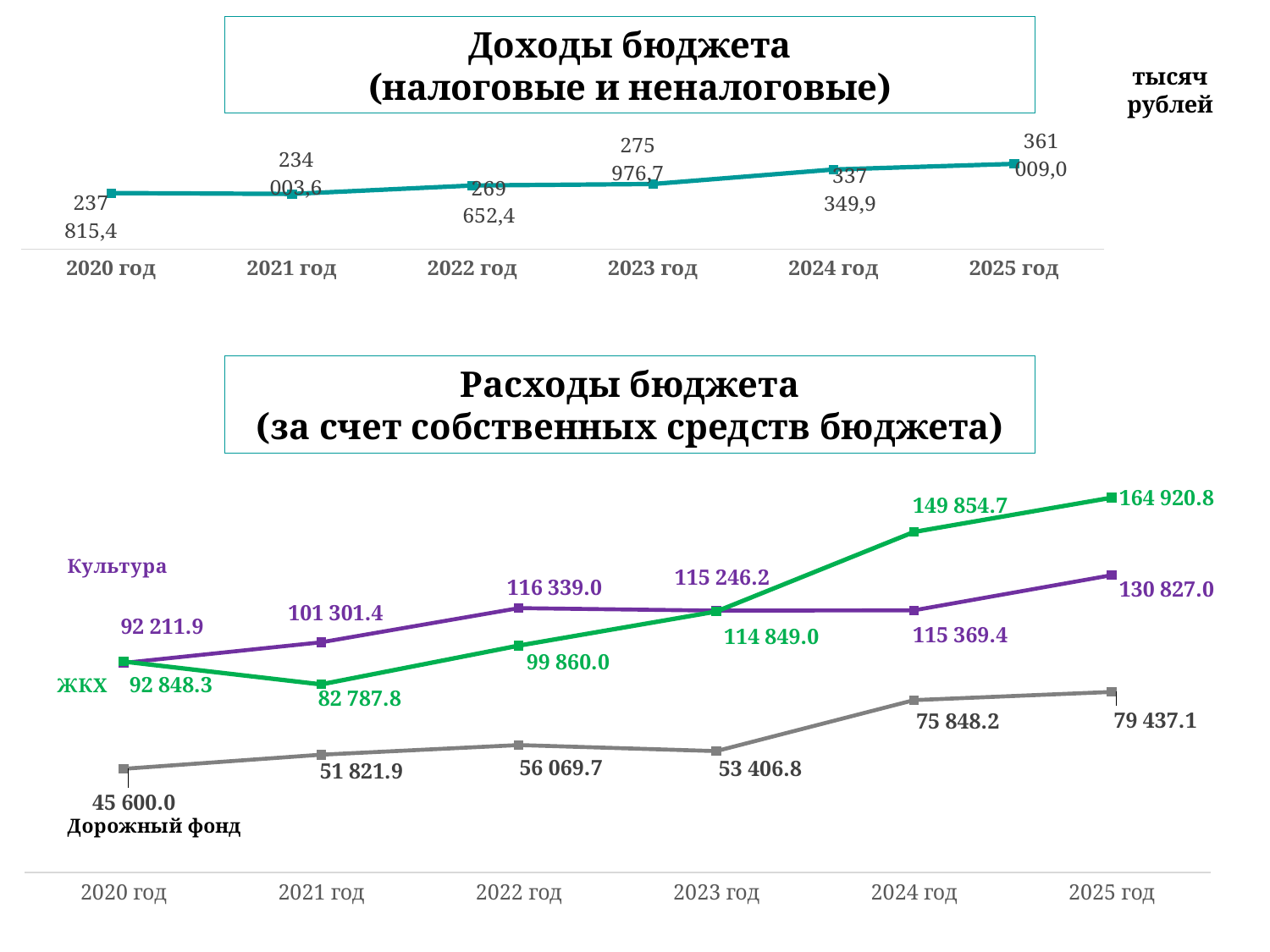
What type of chart is used for "Расходы бюджета (за счет собственных средств бюджета)"? Line chart On the chart titled "Доходы бюджета (налоговые и неналоговые)", which year has the lowest value? 2021 год On the chart titled "Доходы бюджета (налоговые и неналоговые)", which year has the highest value? 2025 год On the chart titled "Расходы бюджета (за счет собственных средств бюджета)", which series has the highest value in 2025 год? ЖКХ On the chart titled "Доходы бюджета (налоговые и неналоговые)", how many years are plotted? 6 On the chart titled "Расходы бюджета (за счет собственных средств бюджета)", which is larger in 2021 год: Культура or ЖКХ? Культура On the chart titled "Расходы бюджета (за счет собственных средств бюджета)", what is the value for Культура in 2022 год? 116 339.0 On the chart titled "Доходы бюджета (налоговые и неналоговые)", what is the value for 2021 год? 234 003,6 On the chart titled "Расходы бюджета (за счет собственных средств бюджета)", what is the value for ЖКХ in 2024 год? 149 854.7 On the chart titled "Расходы бюджета (за счет собственных средств бюджета)", what is the value for Дорожный фонд in 2020 год? 45 600.0 On the chart titled "Доходы бюджета (налоговые и неналоговые)", what is the value for 2025 год? 361 009,0 On the chart titled "Расходы бюджета (за счет собственных средств бюджета)", what is the difference between ЖКХ in 2025 год and ЖКХ in 2024 год? 15 066.1